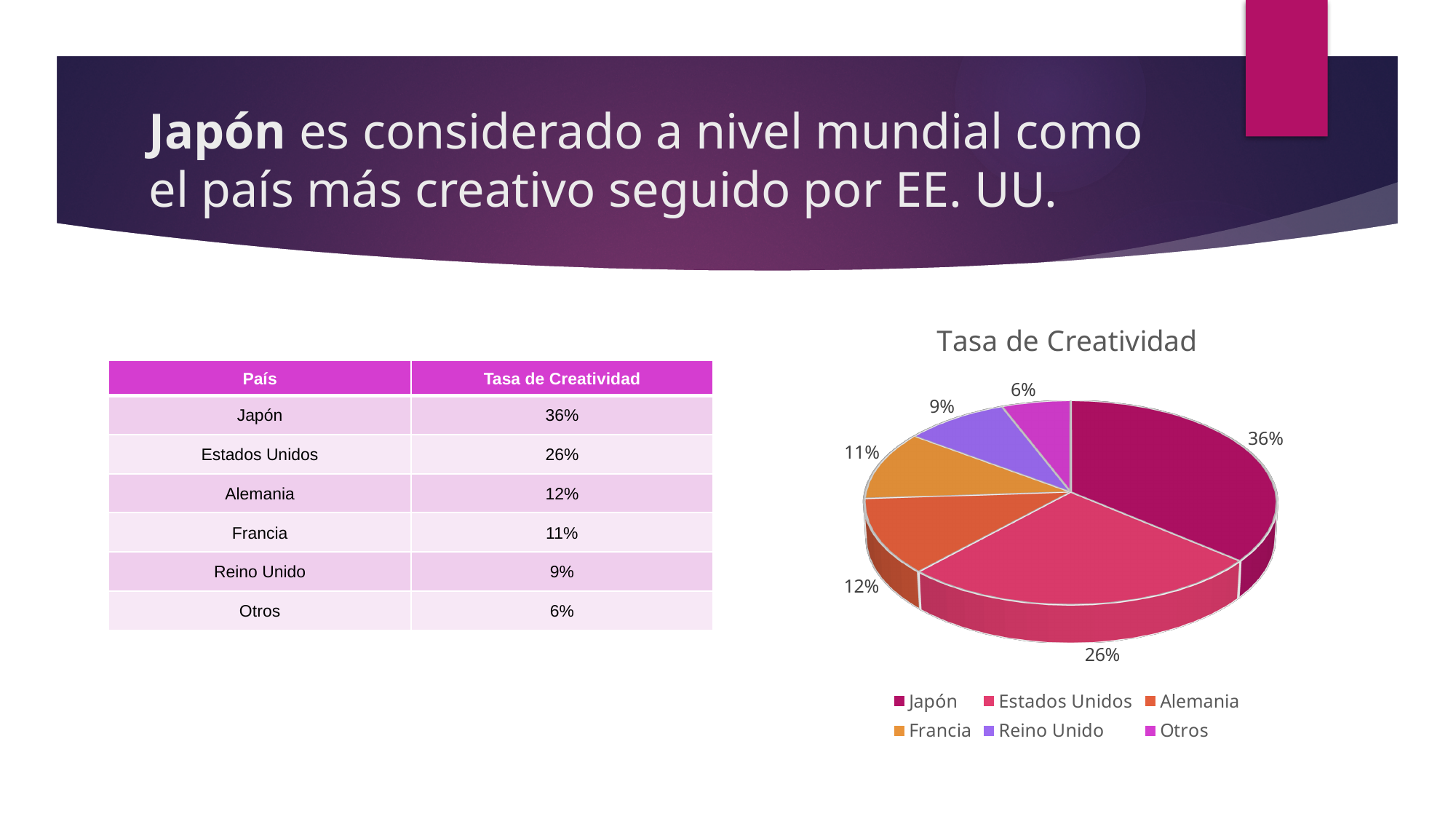
What is the value for Estados Unidos in the pie chart? 26% How many slices does the pie chart have? 6 What is the difference between the values for Japón and Estados Unidos? 10% What is the value for Japón in the pie chart? 36% What type of chart is shown on the slide? Pie chart What is the title of the chart? Tasa de Creatividad Which category has the largest slice in the pie chart? Japón Which category has the smallest slice in the pie chart? Otros Which is larger, the value for Alemania or the value for Reino Unido? Alemania What is the difference between the values for Reino Unido and Otros? 3% How many entries does the legend list? 6 What is the value for Francia in the pie chart? 11%